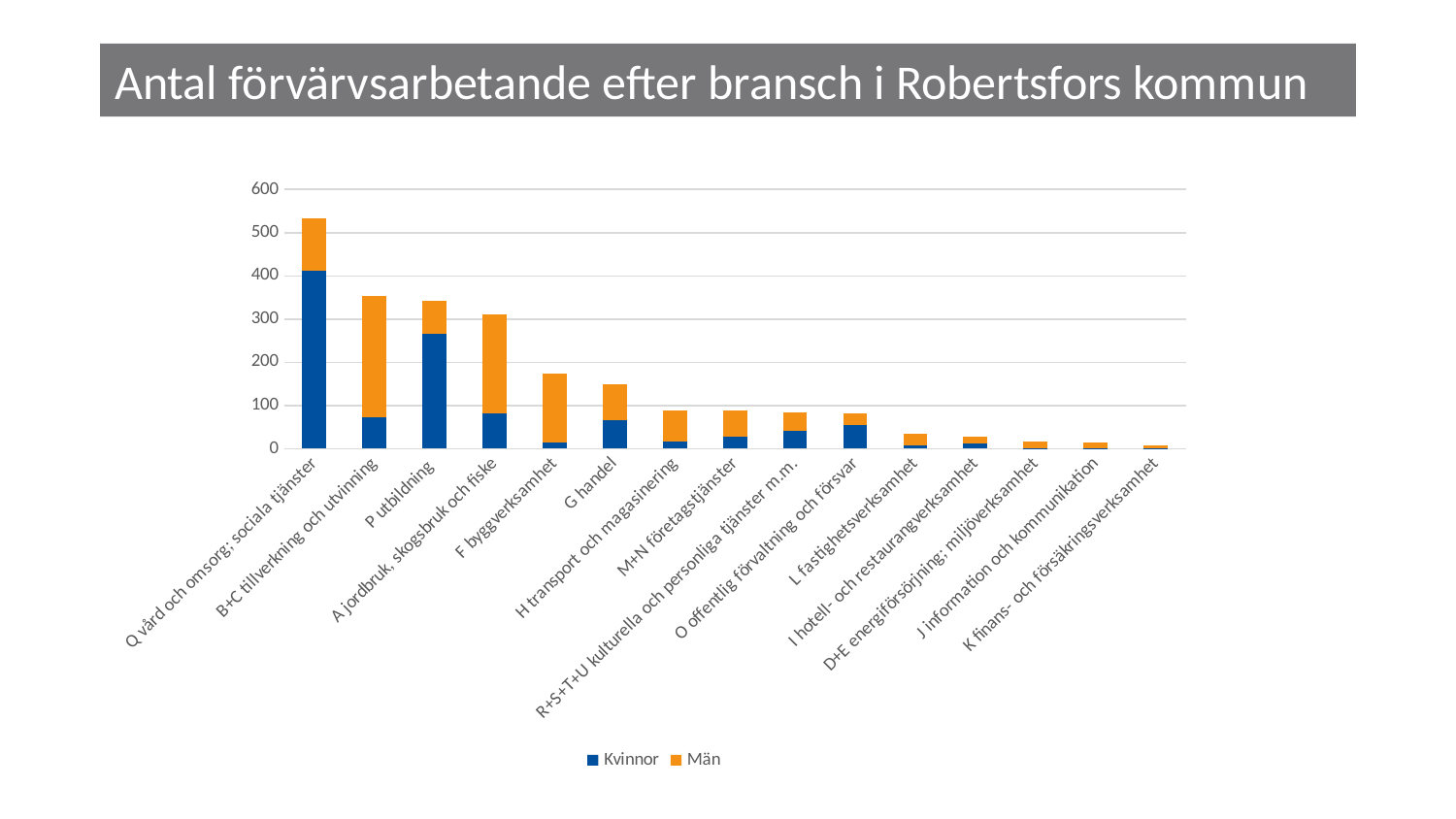
Do the total bar values rise or fall from left to right along the x axis? fall Is the total value for F byggverksamhet greater or less than 200? less How many series does the legend list? 2 Which has a larger total, Q vård och omsorg; sociala tjänster or B+C tillverkning och utvinning? Q vård och omsorg; sociala tjänster How many industry categories are shown on the x axis? 15 Is the Kvinnor value for P utbildning greater or less than 200? greater What is the title of the chart? Antal förvärvsarbetande efter bransch i Robertsfors kommun Is the total value for Q vård och omsorg; sociala tjänster greater or less than 500? greater Which two series are listed in the legend? Kvinnor and Män What kind of chart is shown on the slide? Stacked bar chart Which industry has the lowest total number of employed persons? K finans- och försäkringsverksamhet Which industry has the highest total number of employed persons? Q vård och omsorg; sociala tjänster